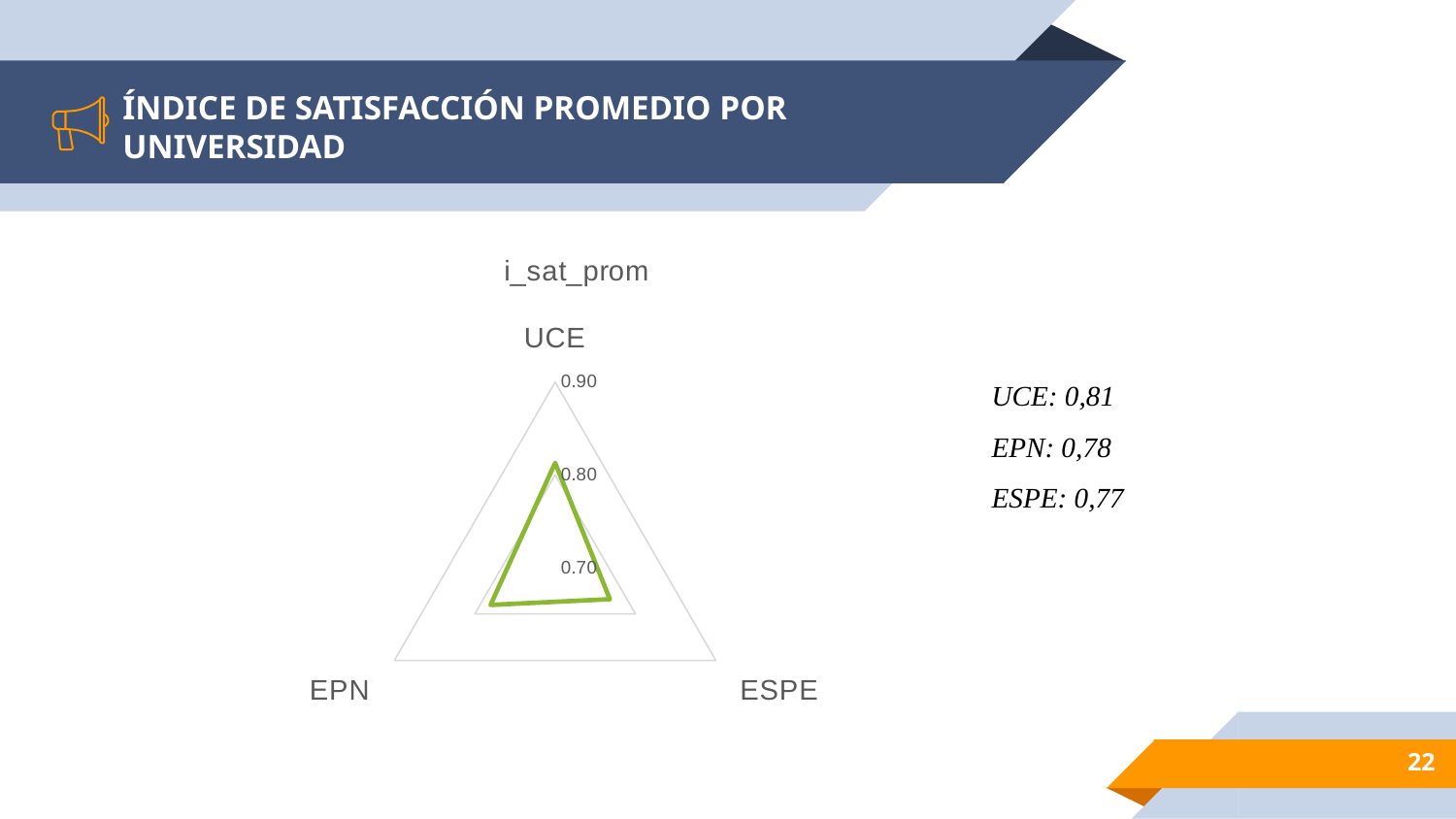
What kind of chart is shown on the slide? Radar chart What is the satisfaction index value for ESPE? 0,77 How many universities are plotted on the chart? 3 What is the difference between the satisfaction index of UCE and ESPE? 0,04 Which has a higher satisfaction index, UCE or ESPE? UCE What is the satisfaction index value for UCE? 0,81 Is the value for EPN greater or less than 0.70? greater What is the difference between the satisfaction index of UCE and EPN? 0,03 Which university has the highest average satisfaction index? UCE What is the satisfaction index value for EPN? 0,78 What is the title of the chart? i_sat_prom Which university has the lowest average satisfaction index? ESPE